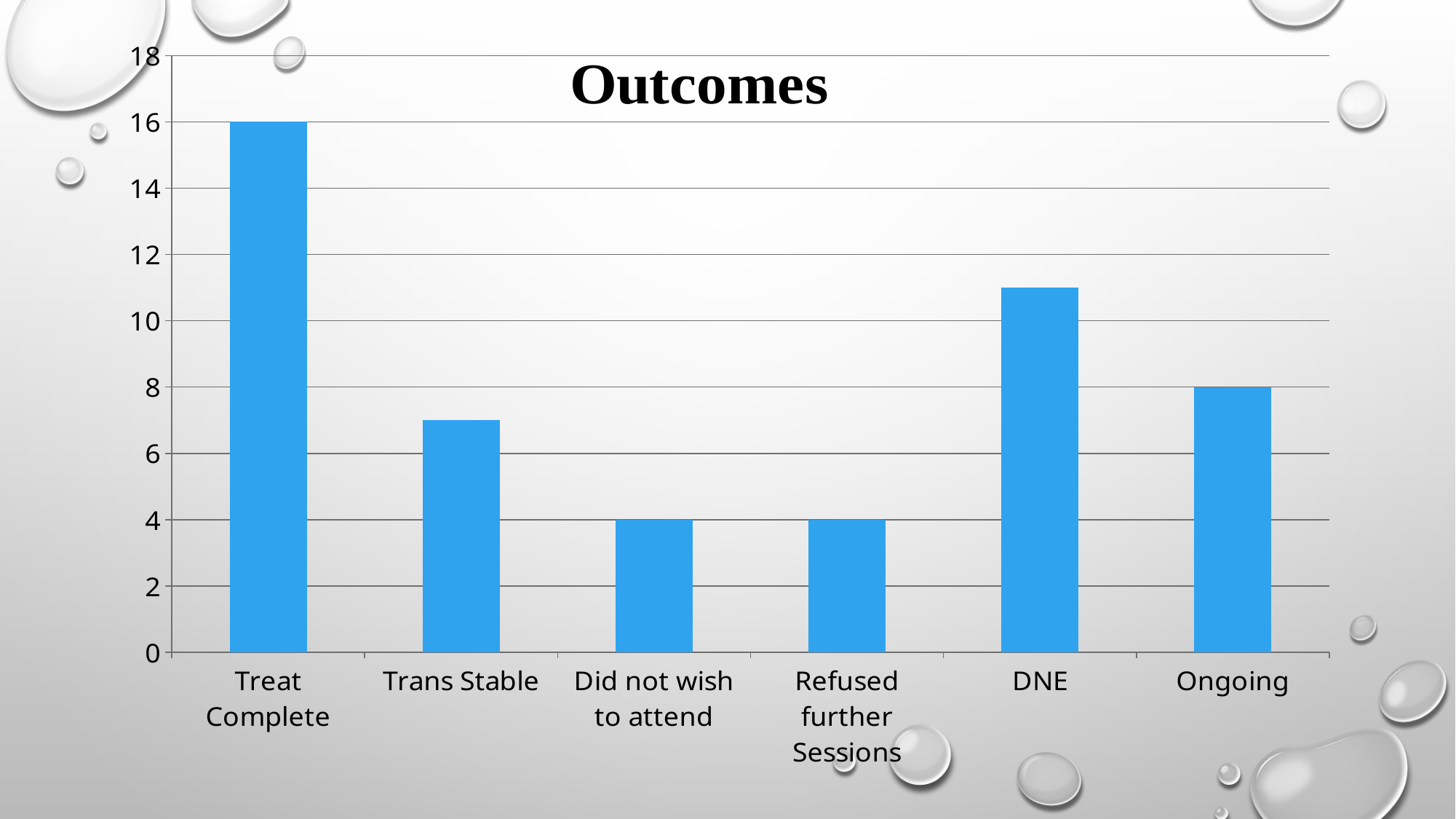
What is the value for Ongoing? 8 What is the value for Treat Complete? 16 What is the title of the chart? Outcomes Which category has the highest value? Treat Complete Is the value for Trans Stable greater or less than 8? less What is the value for Did not wish to attend? 4 What is the value for Refused further Sessions? 4 Is the value for DNE greater or less than 10? greater How many categories are shown on the x axis? 6 What is the difference between the values for Treat Complete and Ongoing? 8 Which is larger, the value for DNE or the value for Ongoing? DNE What type of chart is shown on the slide? bar chart